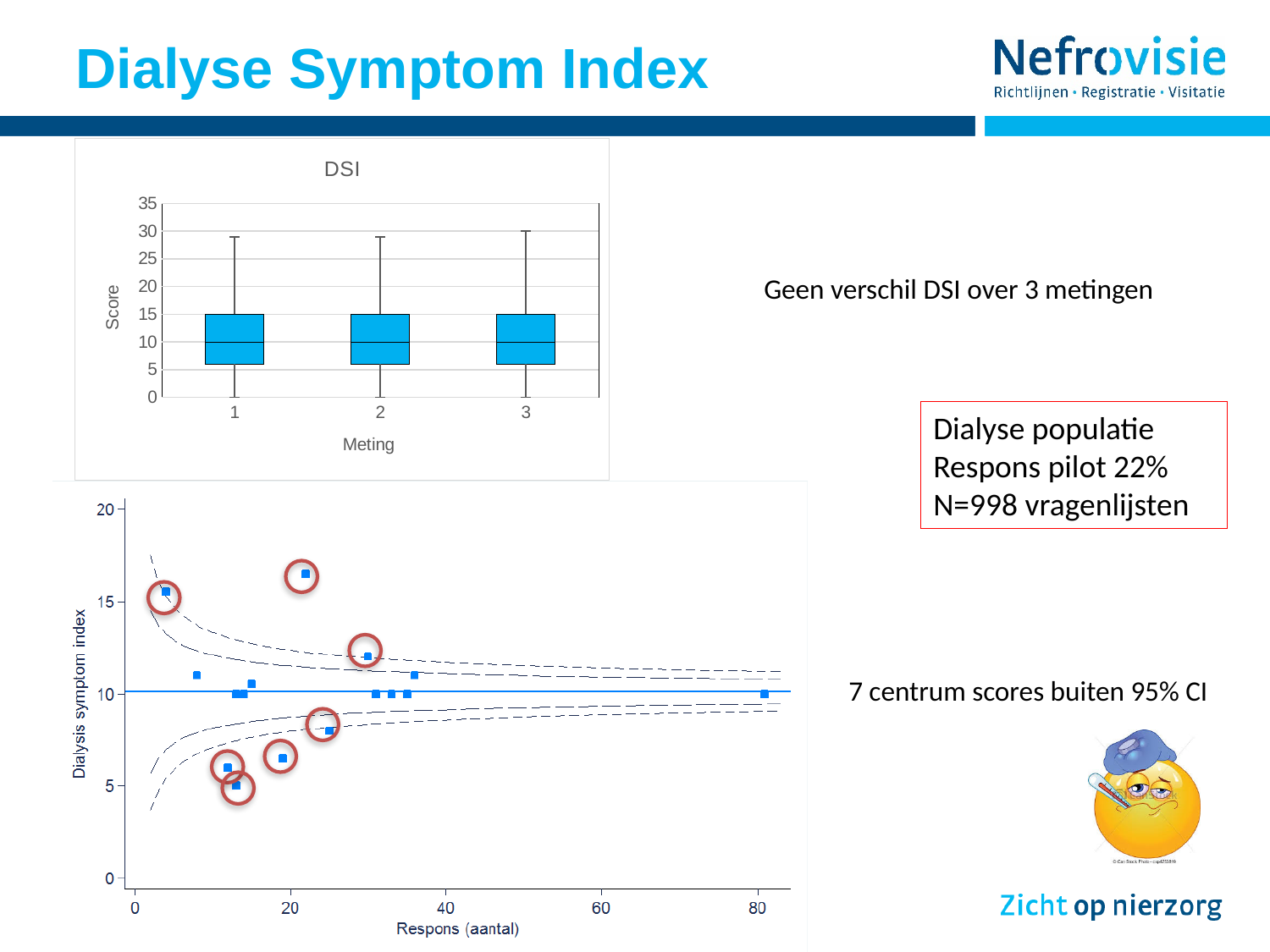
What kind of chart is the bottom chart plotting Dialysis symptom index against Respons (aantal)? scatter plot In the top chart titled DSI, is the median score for Meting 1 greater or less than 15? less In the bottom chart, is the rightmost plotted point (at about 80 respons) greater or less than 15 on the Dialysis symptom index axis? less In the top chart titled DSI, is the bottom of the box for Meting 2 greater or less than 5? greater In the top chart titled DSI, how many metingen (measurements) are shown on the x axis? 3 What kind of chart is the top chart titled DSI? box plot What is the title of the top chart? DSI In the top chart titled DSI, do the median scores rise, fall, or stay the same from Meting 1 to Meting 3? stay the same In the bottom chart, how many points are circled in red? 7 What is the x-axis label of the bottom chart? Respons (aantal)